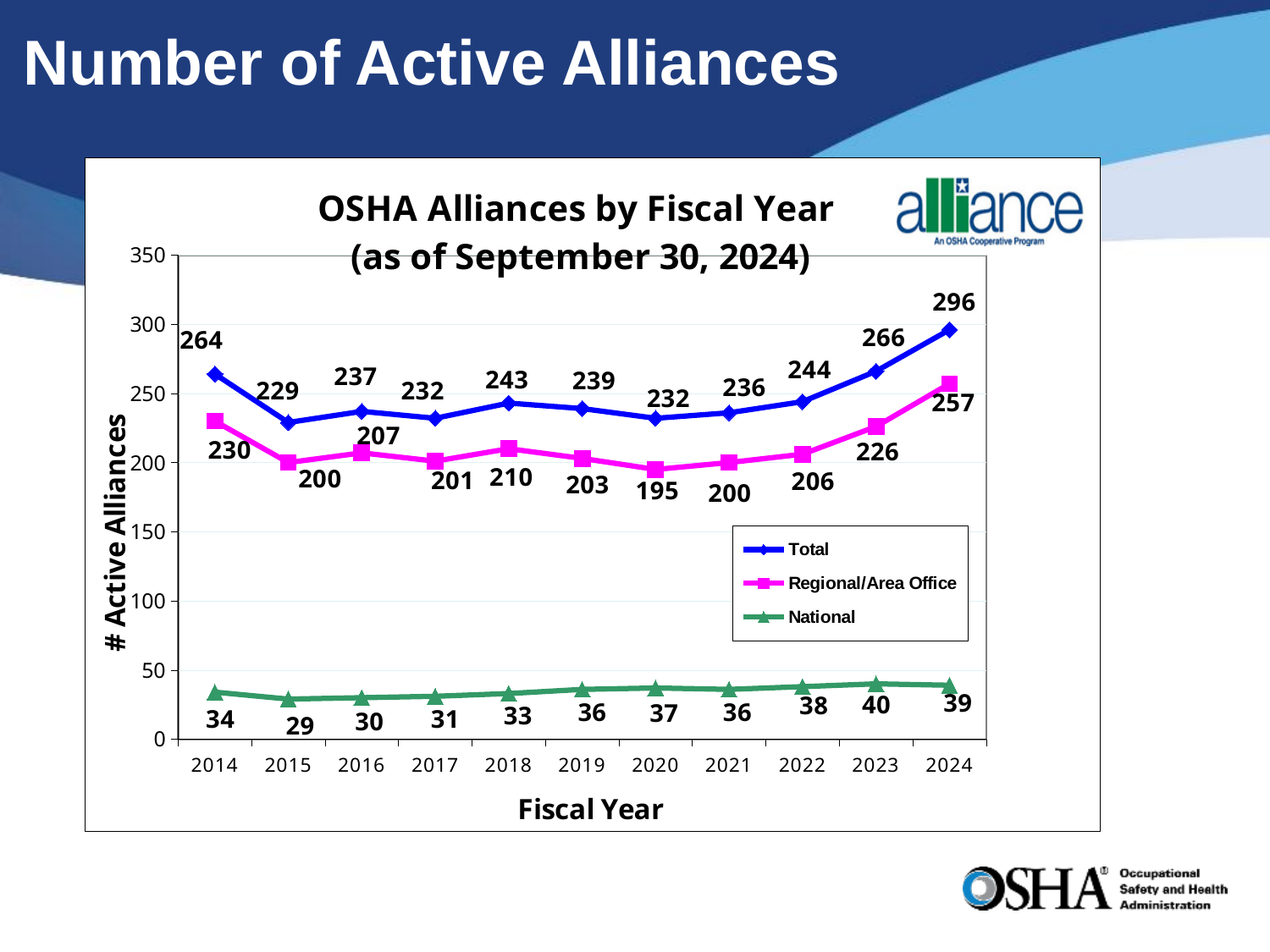
What is the National value for fiscal year 2015? 29 Which is larger, the Regional/Area Office value for 2018 or for 2019? 2018 What is the difference between the Total values for 2024 and 2023? 30 What is the Regional/Area Office value for fiscal year 2020? 195 How many series does the legend list? 3 What is the difference between the Regional/Area Office values for 2014 and 2015? 30 In which fiscal year is the National series at its highest? 2023 What is the Total number of active alliances in fiscal year 2024? 296 What kind of chart is shown on the slide? Line chart What is the title of the chart? OSHA Alliances by Fiscal Year (as of September 30, 2024) In which fiscal year is the Total series at its lowest? 2015 How many fiscal years are shown on the x axis? 11